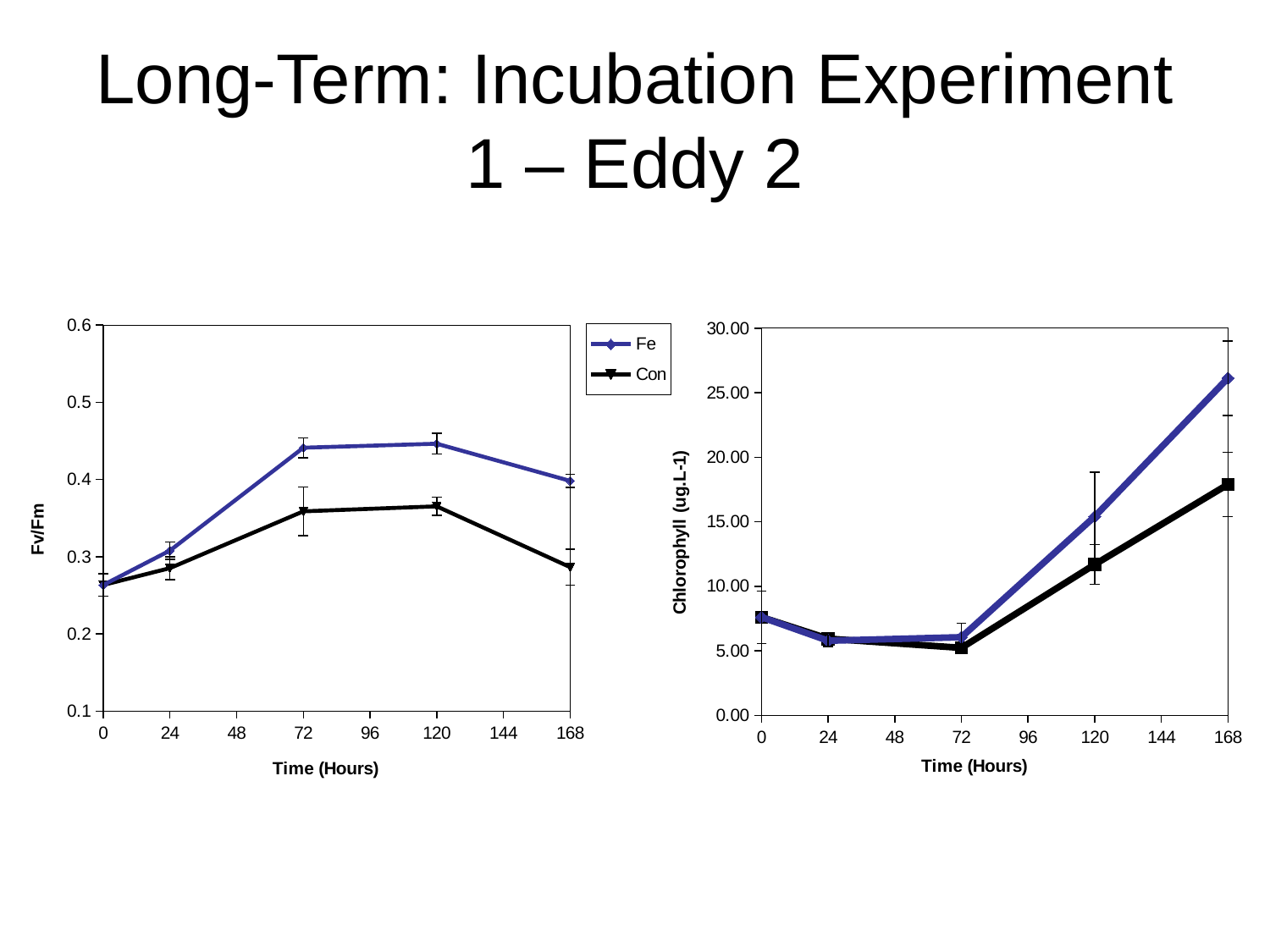
How many time points are plotted for each series in the left chart (Fv/Fm)? 5 In the left chart (Fv/Fm), which series has the higher value at 72 hours, Fe or Con? Fe In the left chart (Fv/Fm), is the Con value at 72 hours greater or less than 0.3? greater In the right chart (Chlorophyll), do the values rise or fall between 72 and 168 hours? rise What kind of chart is the left chart (Fv/Fm)? line chart How many series does the legend of the left chart (Fv/Fm) list? 2 What are the two series named in the legend of the left chart (Fv/Fm)? Fe and Con In the left chart (Fv/Fm), is the Fe value at 0 hours greater or less than 0.3? less In the right chart (Chlorophyll), is the black line's value at 168 hours greater or less than 20.00? less What is the y-axis label of the right chart? Chlorophyll (ug.L-1)